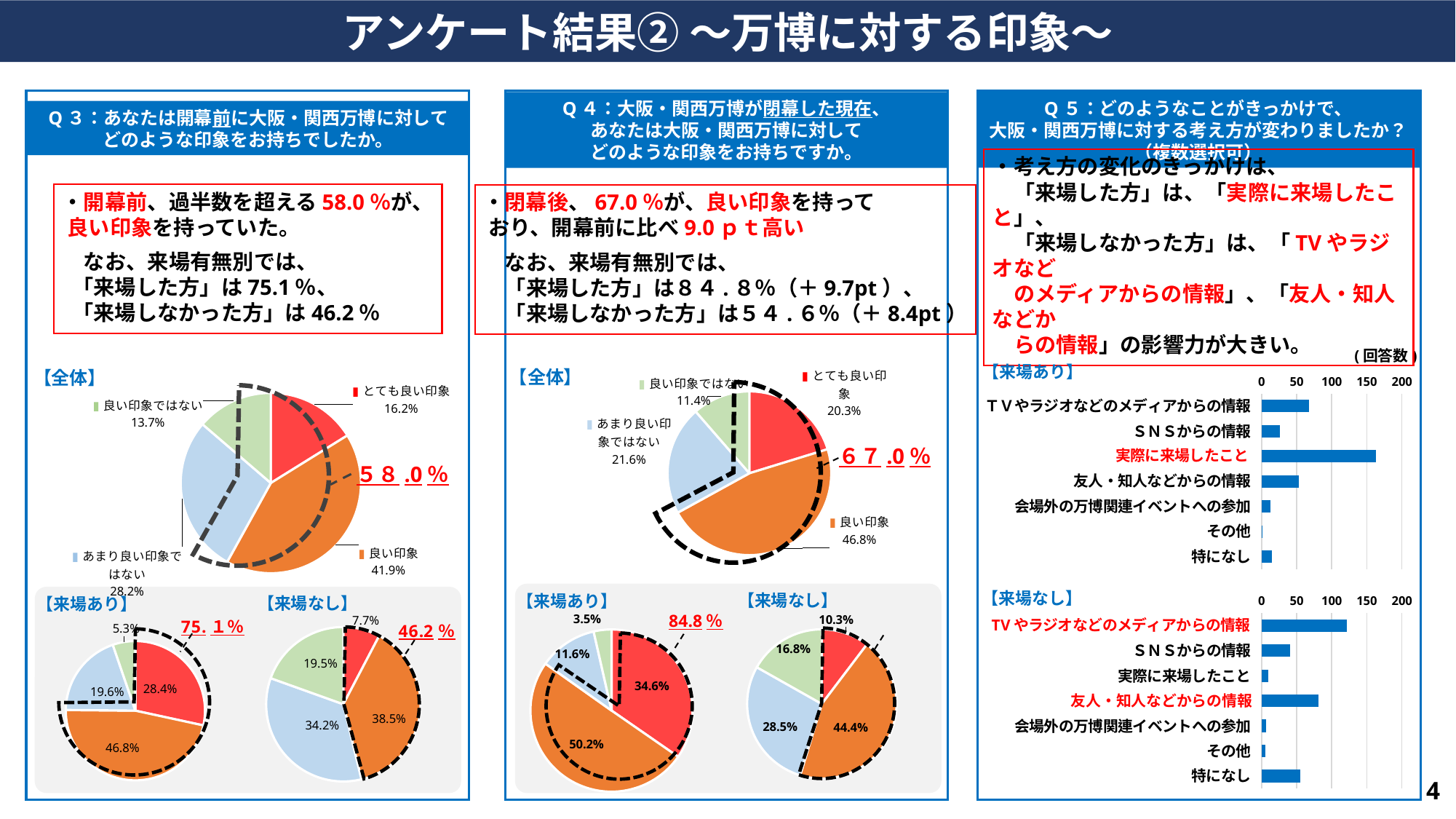
In the Q5【来場なし】bar chart, is the value for TVやラジオなどのメディアからの情報 greater or less than 100? greater In the Q3【来場あり】pie chart, what is the smallest slice's percentage? 5.3% Which is larger: the 46.8% slice in the Q3【来場あり】pie chart or the 38.5% slice in the Q3【来場なし】pie chart? The 46.8% slice in the Q3【来場あり】pie chart What is the difference between the 良い印象 share in the Q4【全体】pie chart (46.8%) and the 良い印象 share in the Q3【全体】pie chart (41.9%)? 4.9 percentage points How many categories are shown in the Q5【来場あり】bar chart? 7 In the Q4【全体】pie chart, what percentage is labelled for あまり良い印象ではない? 21.6% In the Q5【来場なし】bar chart, which category has the longest bar? TVやラジオなどのメディアからの情報 In the Q3【全体】pie chart, what percentage is labelled for とても良い印象? 16.2% In the Q5【来場あり】bar chart, which category has the longest bar? 実際に来場したこと In the Q4【来場あり】pie chart, what is the largest slice's percentage? 50.2% In the Q3【全体】pie chart, what percentage is labelled for 良い印象? 41.9% What kind of chart is used for the Q5 results? Bar chart